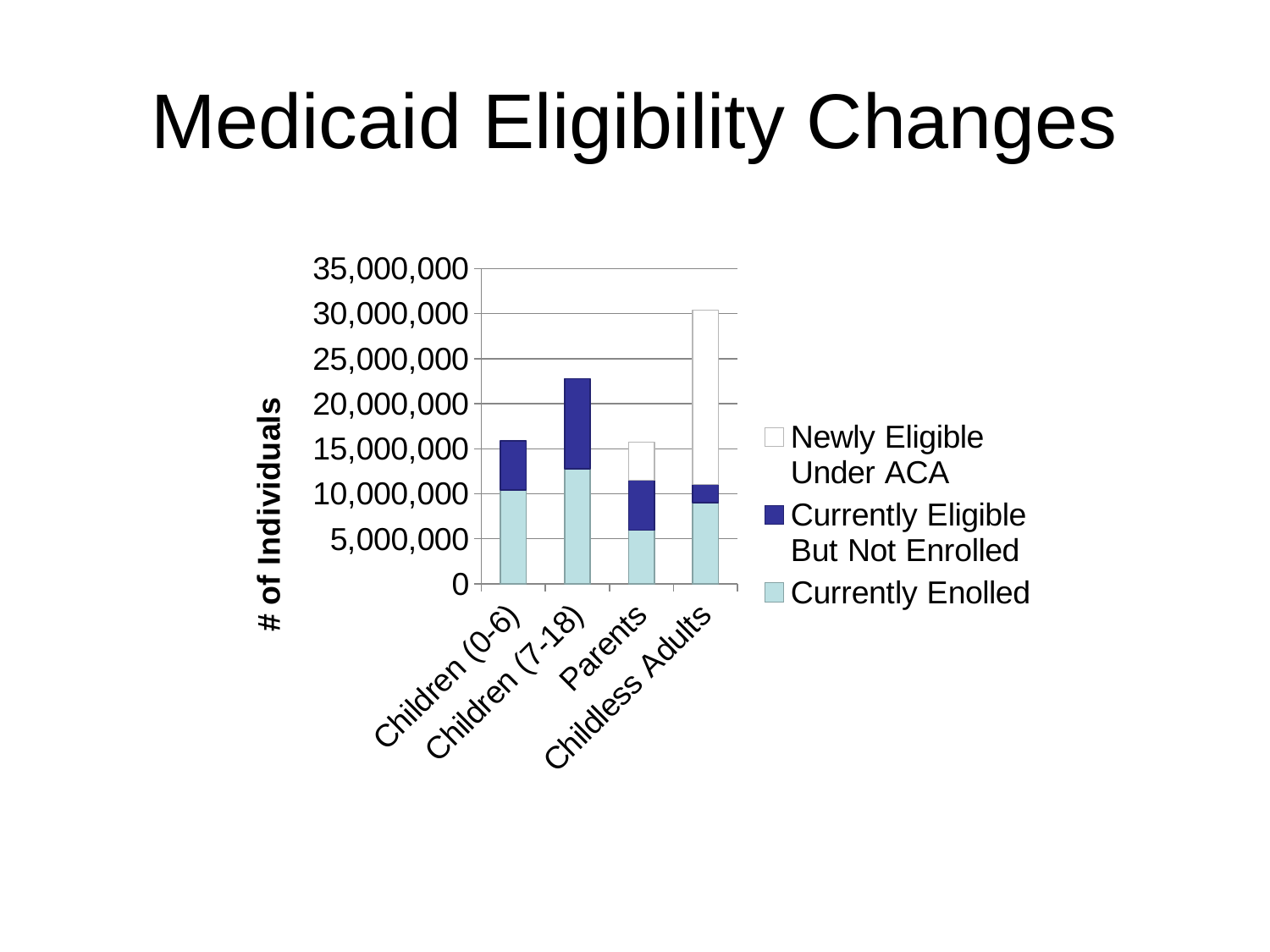
Is the total stacked bar for Childless Adults greater or less than 25,000,000? greater Which category has the tallest stacked bar in the chart? Childless Adults Is the Currently Enolled value for Parents greater or less than 10,000,000? less Is the Currently Enolled value for Children (7-18) greater or less than 10,000,000? greater How many categories are shown on the x axis of the chart? 4 How many series does the chart's legend list? 3 What kind of chart is shown on the slide? Stacked bar chart Which has the larger Currently Enolled value, Children (7-18) or Parents? Children (7-18) Which has the larger total stacked bar, Children (0-6) or Children (7-18)? Children (7-18) What is the title of the chart's vertical axis? # of Individuals